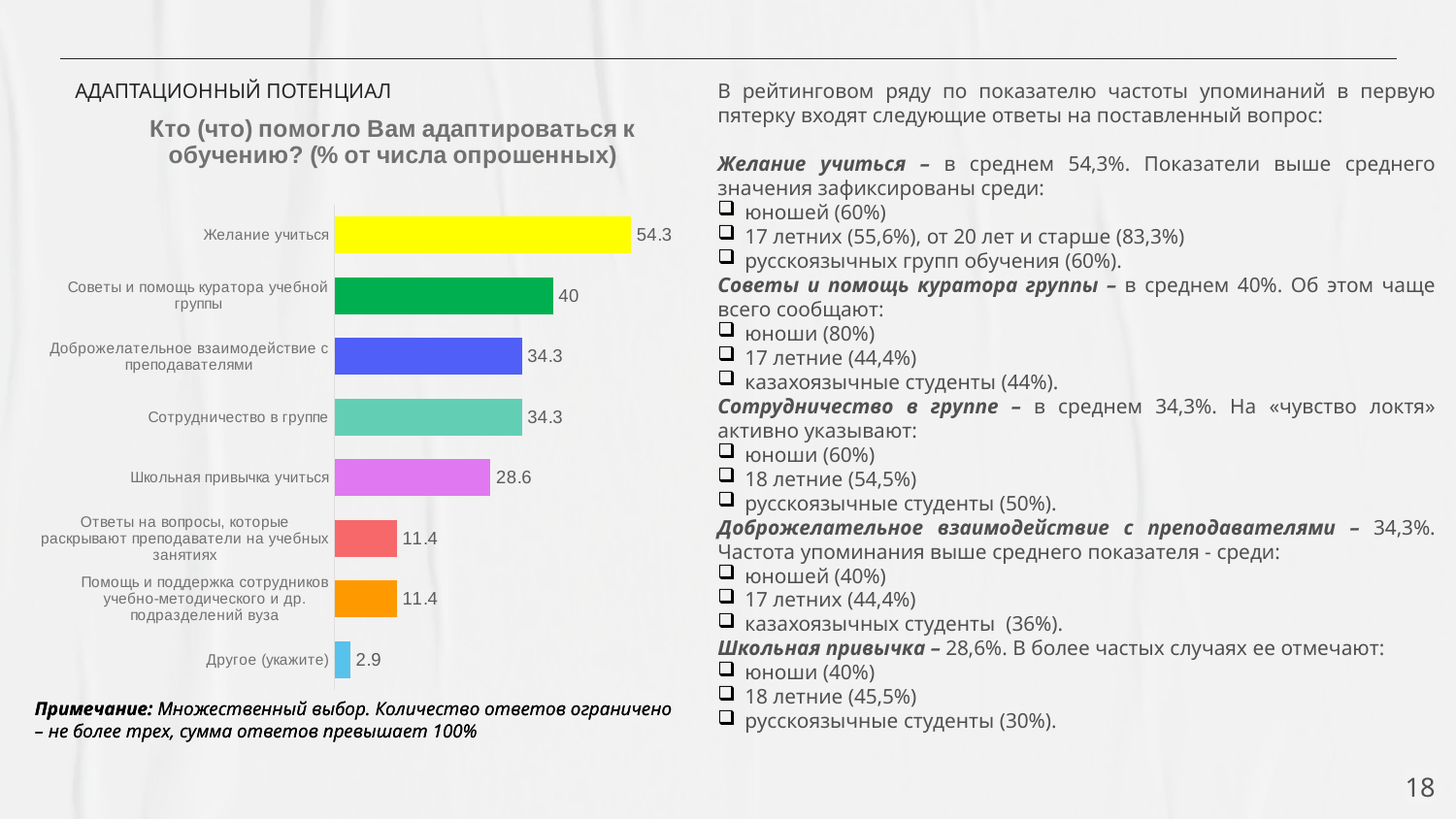
What is the title of the chart? Кто (что) помогло Вам адаптироваться к обучению? (% от числа опрошенных) What is the difference between the values for "Сотрудничество в группе" and "Школьная привычка учиться"? 5.7 What is the difference between the values for "Желание учиться" and "Советы и помощь куратора учебной группы"? 14.3 What value is shown for "Другое (укажите)"? 2.9 What value is shown for "Желание учиться"? 54.3 Which category has the highest value? Желание учиться What kind of chart is shown on the slide? Bar chart What value is shown for "Советы и помощь куратора учебной группы"? 40 How many categories are shown in the chart? 8 Which is larger: the value for "Школьная привычка учиться" or the value for "Другое (укажите)"? Школьная привычка учиться What value is shown for "Школьная привычка учиться"? 28.6 Which category has the lowest value? Другое (укажите)